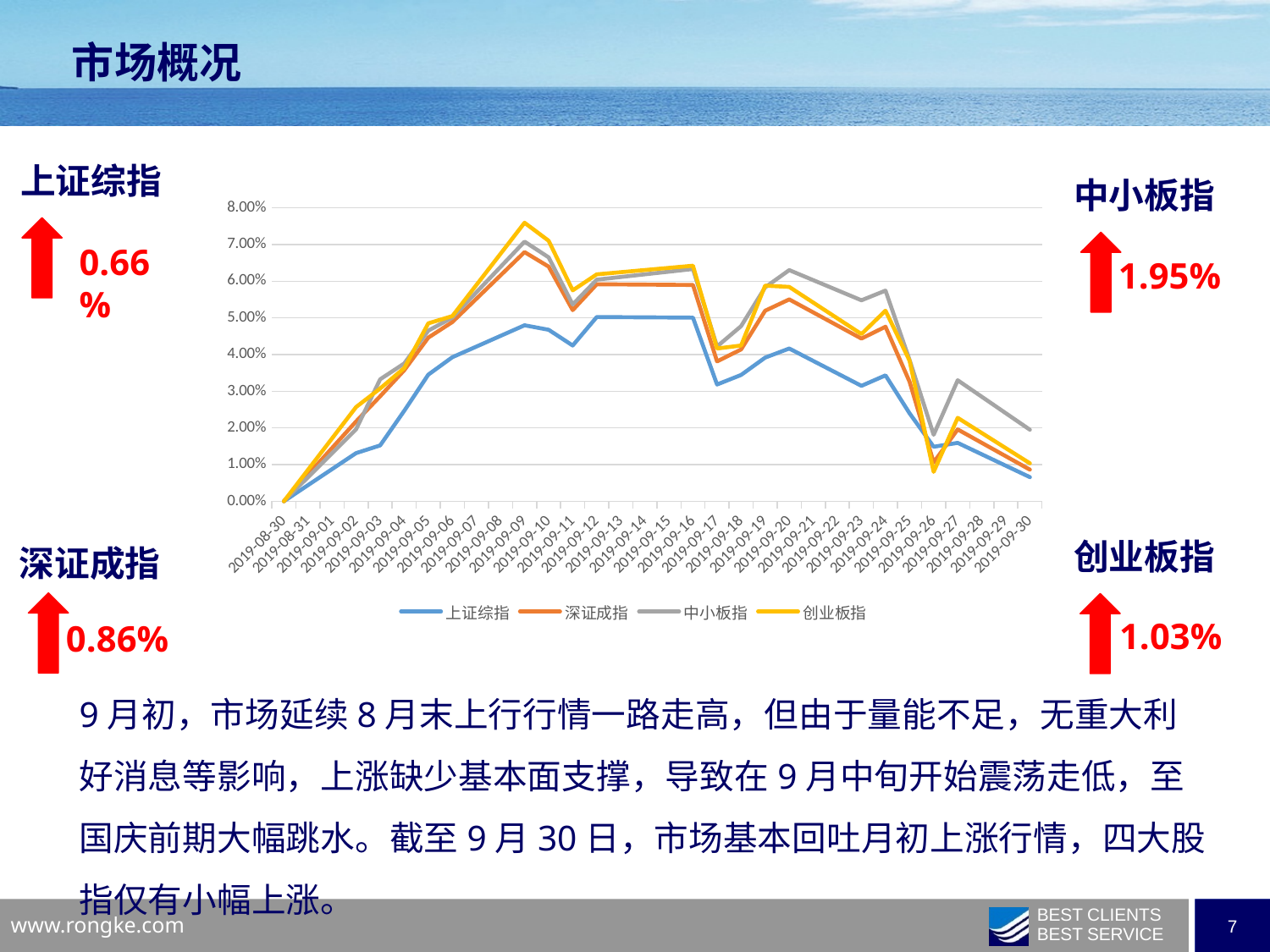
What kind of chart is shown on the slide? line chart Which series has the lowest value on 2019-09-30? 上证综指 How many series does the chart legend list? 4 Which series reaches the highest peak on the chart? 创业板指 How many dates are plotted along the x axis of the chart? 32 Is the value for 上证综指 on 2019-09-30 greater or less than 1.00%? less Is the value for 创业板指 on 2019-09-09 greater or less than 7.00%? greater Is the value for 上证综指 on 2019-09-09 greater or less than 4.00%? greater On 2019-09-20, which is larger: 中小板指 or 上证综指? 中小板指 Do the values of 上证综指 rise or fall from 2019-08-30 to 2019-09-09? rise Which series is drawn in blue on the chart? 上证综指 Which series has the highest value on 2019-09-30? 中小板指